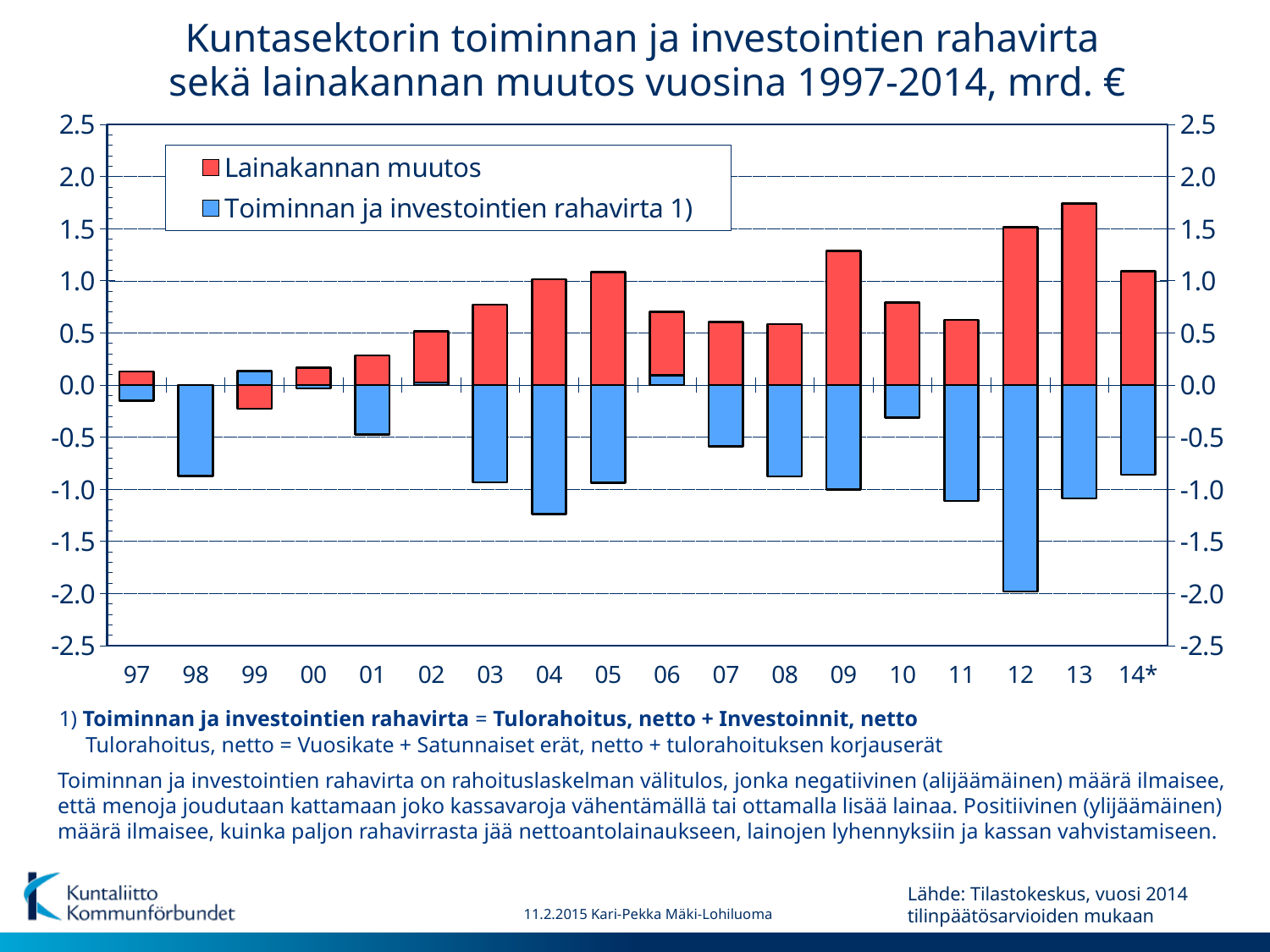
Is the value of Toiminnan ja investointien rahavirta for 04 greater or less than -1.0? less Is the value of Toiminnan ja investointien rahavirta for 12 greater or less than -1.5? less Which colour represents Lainakannan muutos in the legend? red Which year has the larger Lainakannan muutos, 09 or 10? 09 In which year is Lainakannan muutos highest? 13 How many series does the legend list? 2 Is the value of Lainakannan muutos for 13 greater or less than 1.5? greater In which year is Toiminnan ja investointien rahavirta lowest? 12 How many years are shown on the x axis? 18 What kind of chart is shown on the slide? bar chart